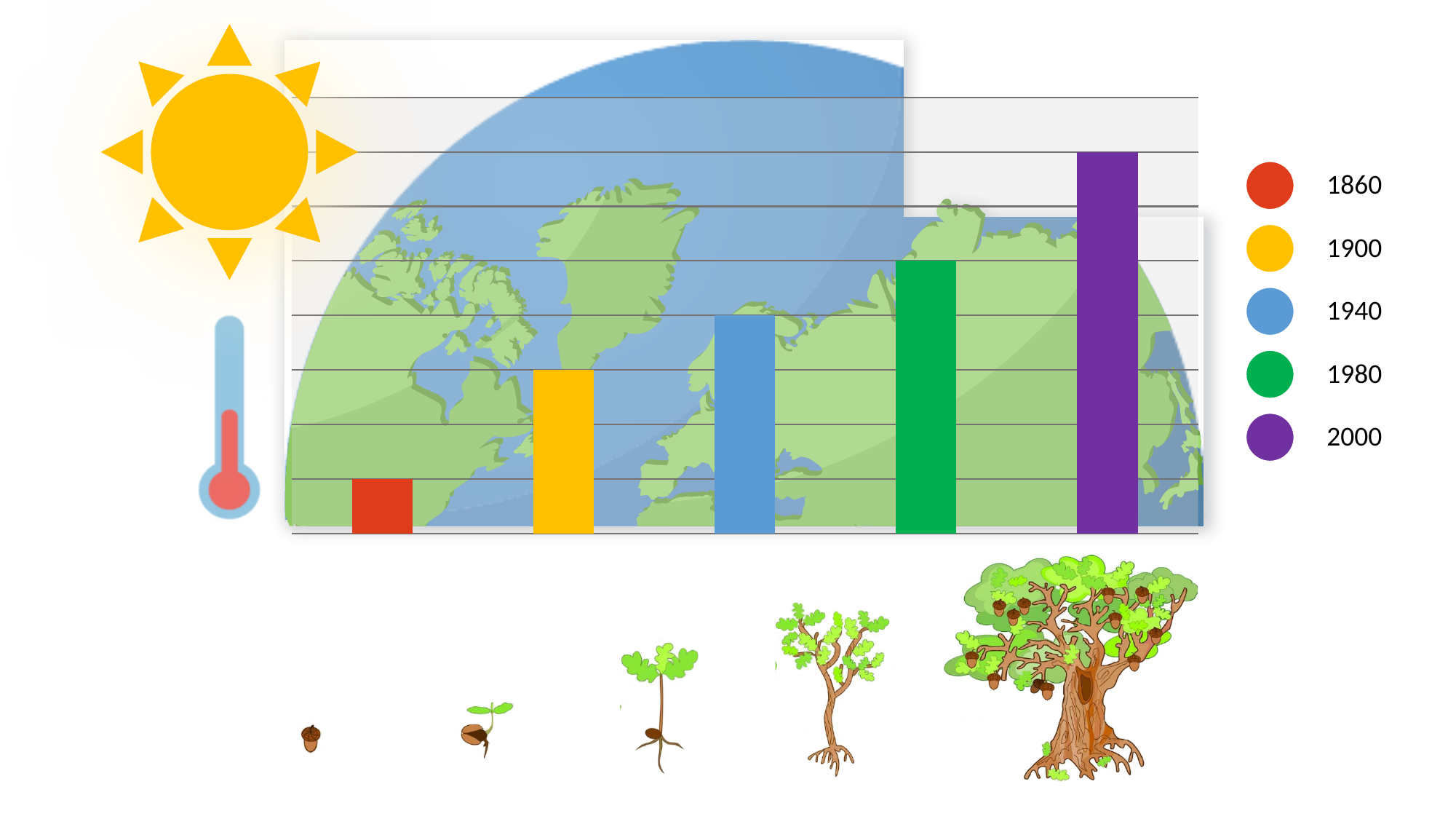
Which bar is taller, 2000 or 1980? 2000 What kind of chart is shown on the slide? bar chart Which year has the shortest bar in the chart? 1860 How many entries does the chart's legend list? 5 Which bar is taller, 1900 or 1940? 1940 Which year does the purple bar represent? 2000 What colour is the bar for 1980 in the chart? green Which year has the tallest bar in the chart? 2000 Which bar is taller, 1980 or 1860? 1980 Do the bar heights rise or fall from 1860 to 2000? rise How many bars are plotted in the chart? 5